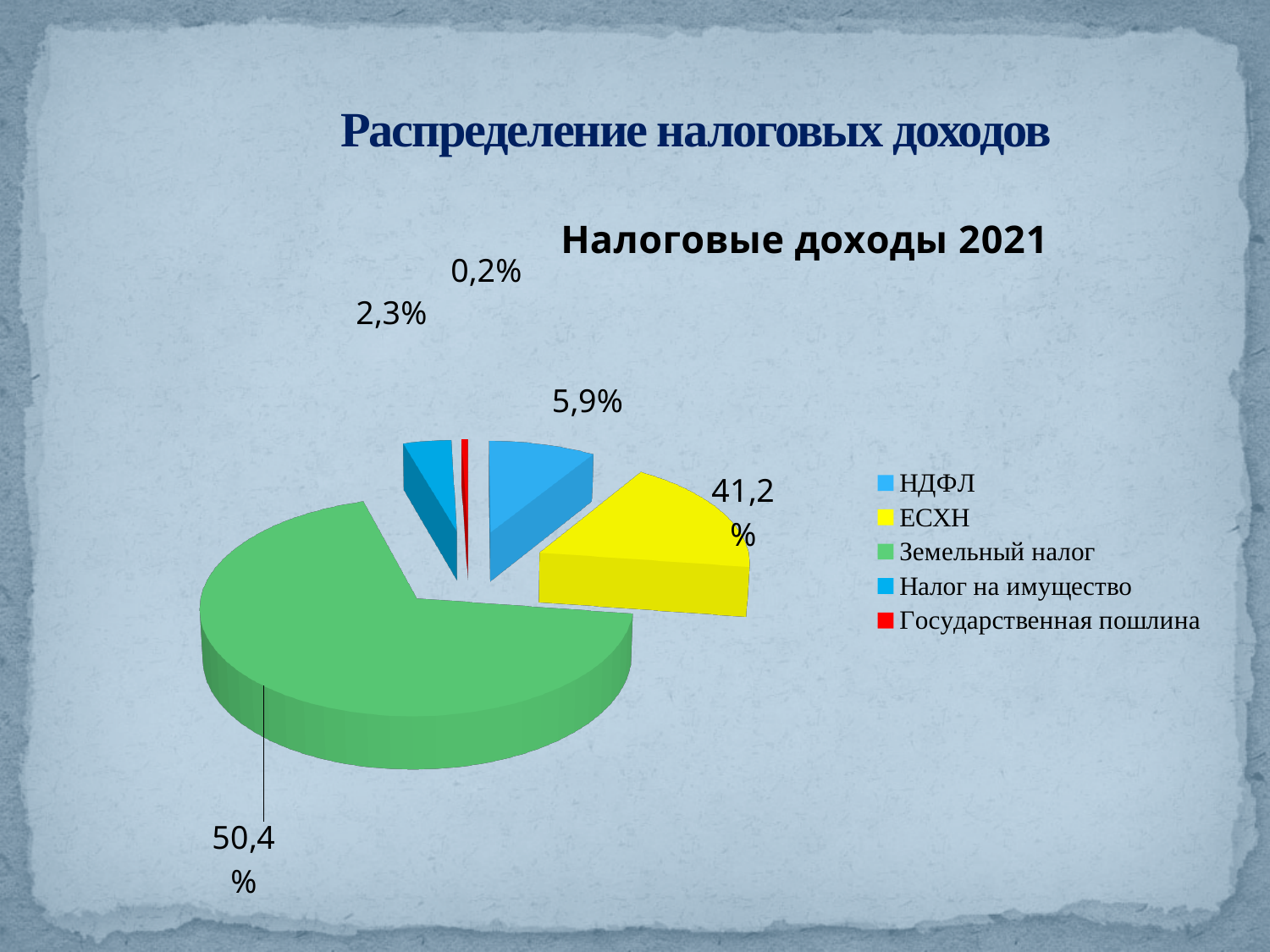
How many categories does the legend of the pie chart list? 5 Which category has the largest share of the pie? Земельный налог Which is larger, the share of НДФЛ or the share of Налог на имущество? НДФЛ What share of the pie does Земельный налог have? 50,4% What is the title of the chart? Налоговые доходы 2021 What share of the pie does НДФЛ have? 5,9% Which category has the smallest share of the pie? Государственная пошлина What share of the pie does ЕСХН have? 41,2% What kind of chart is shown on the slide? pie chart What is the difference between the shares of Земельный налог and ЕСХН? 9,2% What share of the pie does Государственная пошлина have? 0,2% What share of the pie does Налог на имущество have? 2,3%